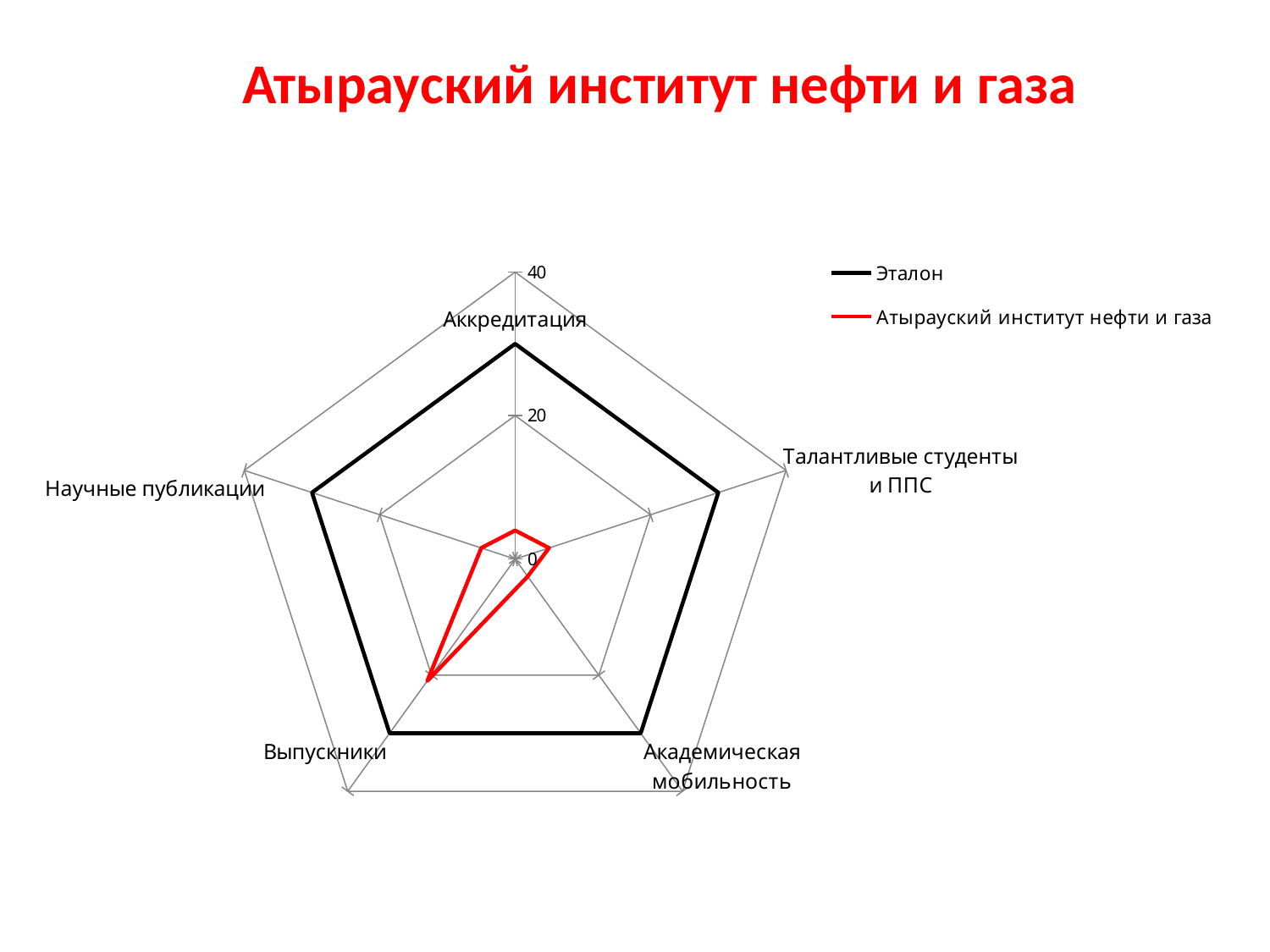
Is the value of Атырауский институт нефти и газа for Талантливые студенты и ППС greater or less than 20? less Which series is drawn in red? Атырауский институт нефти и газа How many series does the legend list? 2 Is the value of Эталон for Выпускники greater or less than 40? less Which series has the larger value for Академическая мобильность, Эталон or Атырауский институт нефти и газа? Эталон Is the value of Эталон for Аккредитация greater or less than 20? greater How many categories (axes) does the radar chart have? 5 Which series has the larger value for Научные публикации, Эталон or Атырауский институт нефти и газа? Эталон What kind of chart is shown on the slide? Radar chart For which category does Атырауский институт нефти и газа have its highest value? Выпускники Which series is drawn in black? Эталон